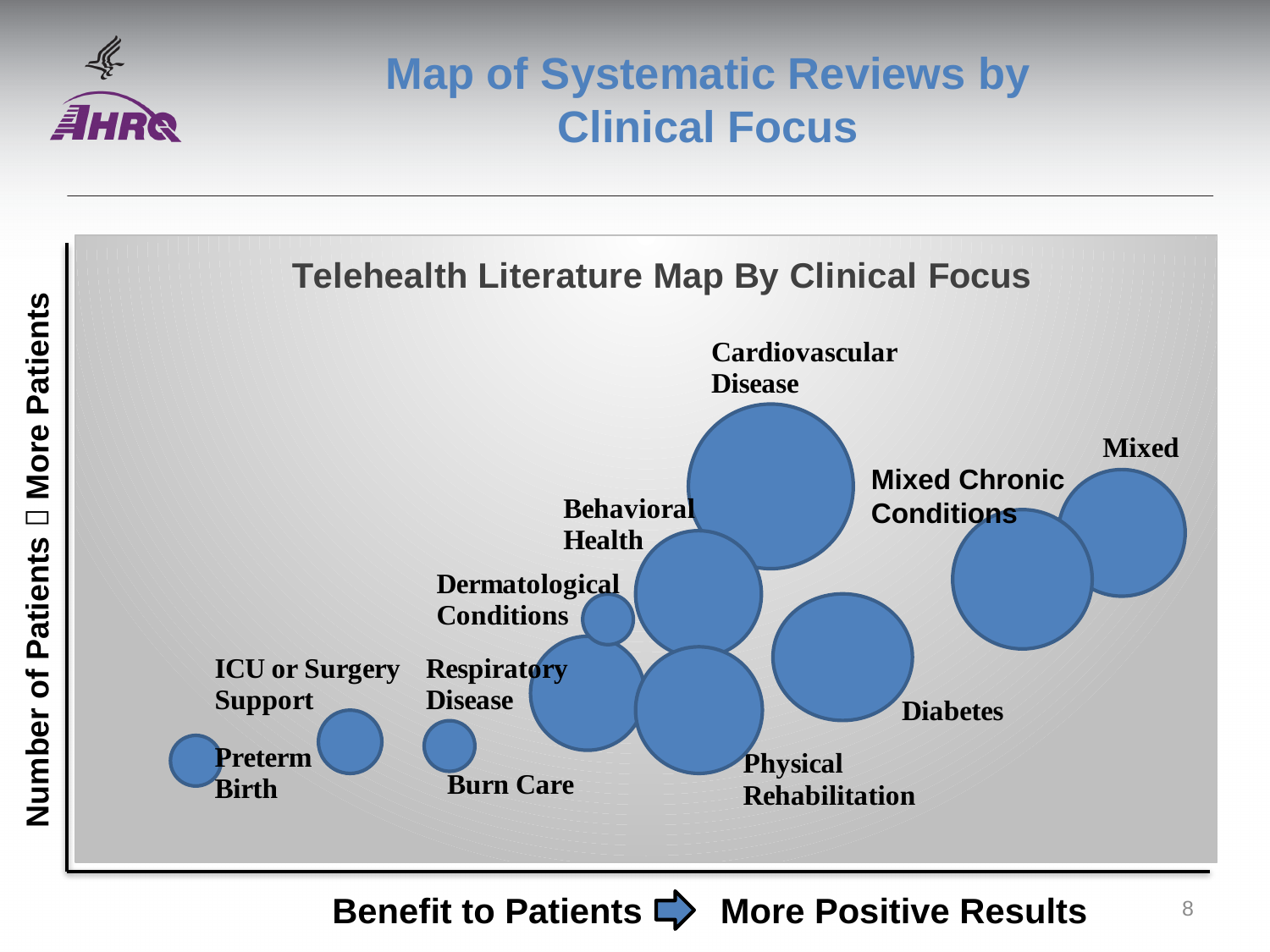
Which is plotted further to the right, Mixed Chronic Conditions or ICU or Surgery Support? Mixed Chronic Conditions Which is plotted higher on the vertical axis, Behavioral Health or Burn Care? Behavioral Health What is the title of the chart? Telehealth Literature Map By Clinical Focus Which bubble is larger, Cardiovascular Disease or Diabetes? Cardiovascular Disease What kind of chart is shown on the slide? Bubble chart Which clinical focus is plotted furthest to the left on the horizontal axis? Preterm Birth What does the vertical axis of the chart represent? Number of Patients Which clinical focus is plotted furthest to the right on the horizontal axis? Mixed Which clinical focus has the largest bubble on the chart? Cardiovascular Disease How many clinical focus bubbles are plotted on the chart? 11 Which clinical focus is plotted highest on the vertical axis? Cardiovascular Disease